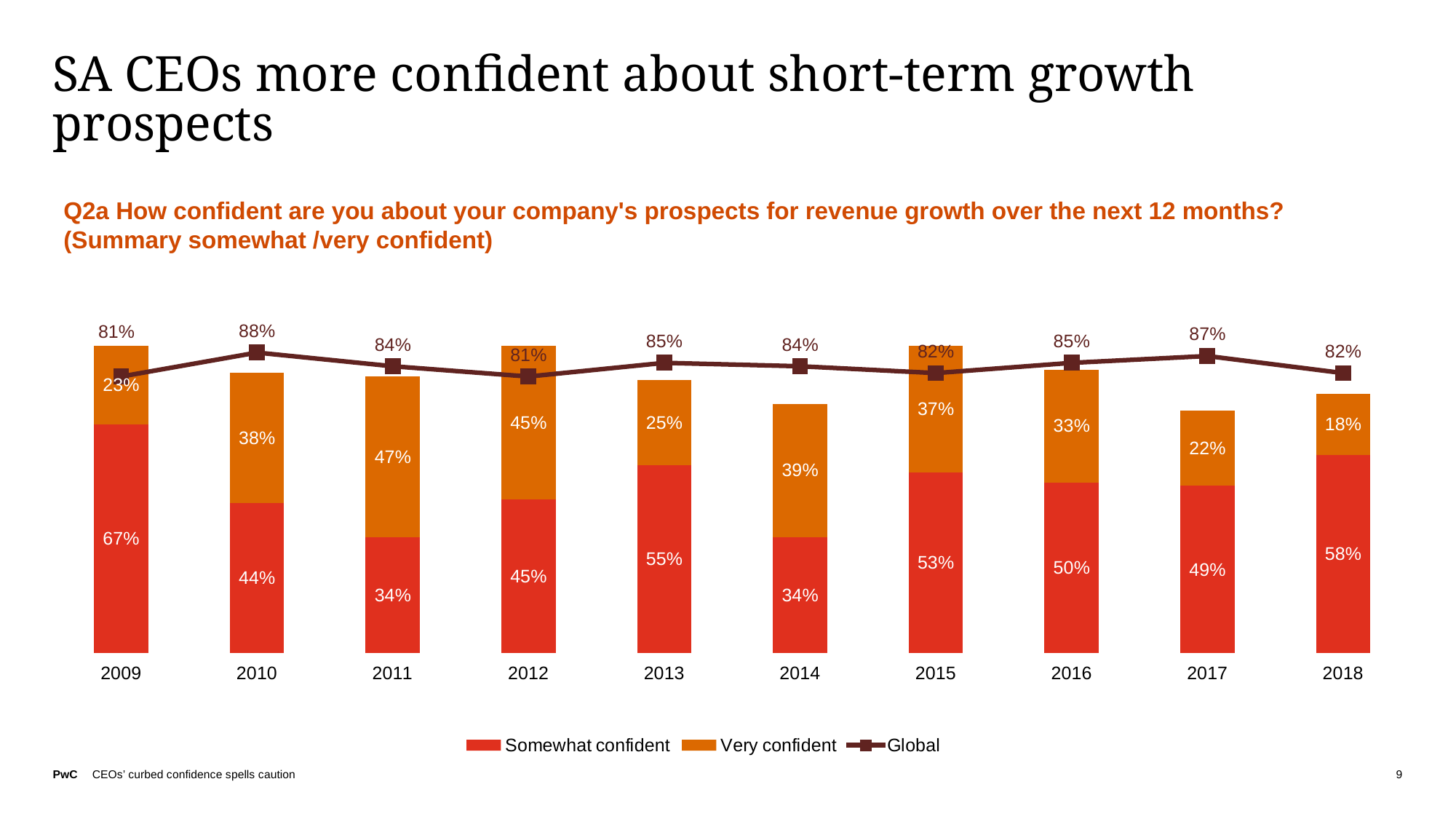
What is the total of the stacked bar for 2015? 90% Which series is shown in red? Somewhat confident What is the Global value for 2017? 87% What is the difference between the Somewhat confident values for 2018 and 2017? 9% How many series does the legend list? 3 In which year is the Very confident value lowest? 2018 Which is larger, the Very confident value for 2014 or for 2016? 2014 What kind of chart is this? Stacked bar chart with a line What is the Somewhat confident value for 2009? 67% In which year is the Global line at its highest? 2010 How many years are shown on the x axis? 10 What is the Very confident value for 2011? 47%